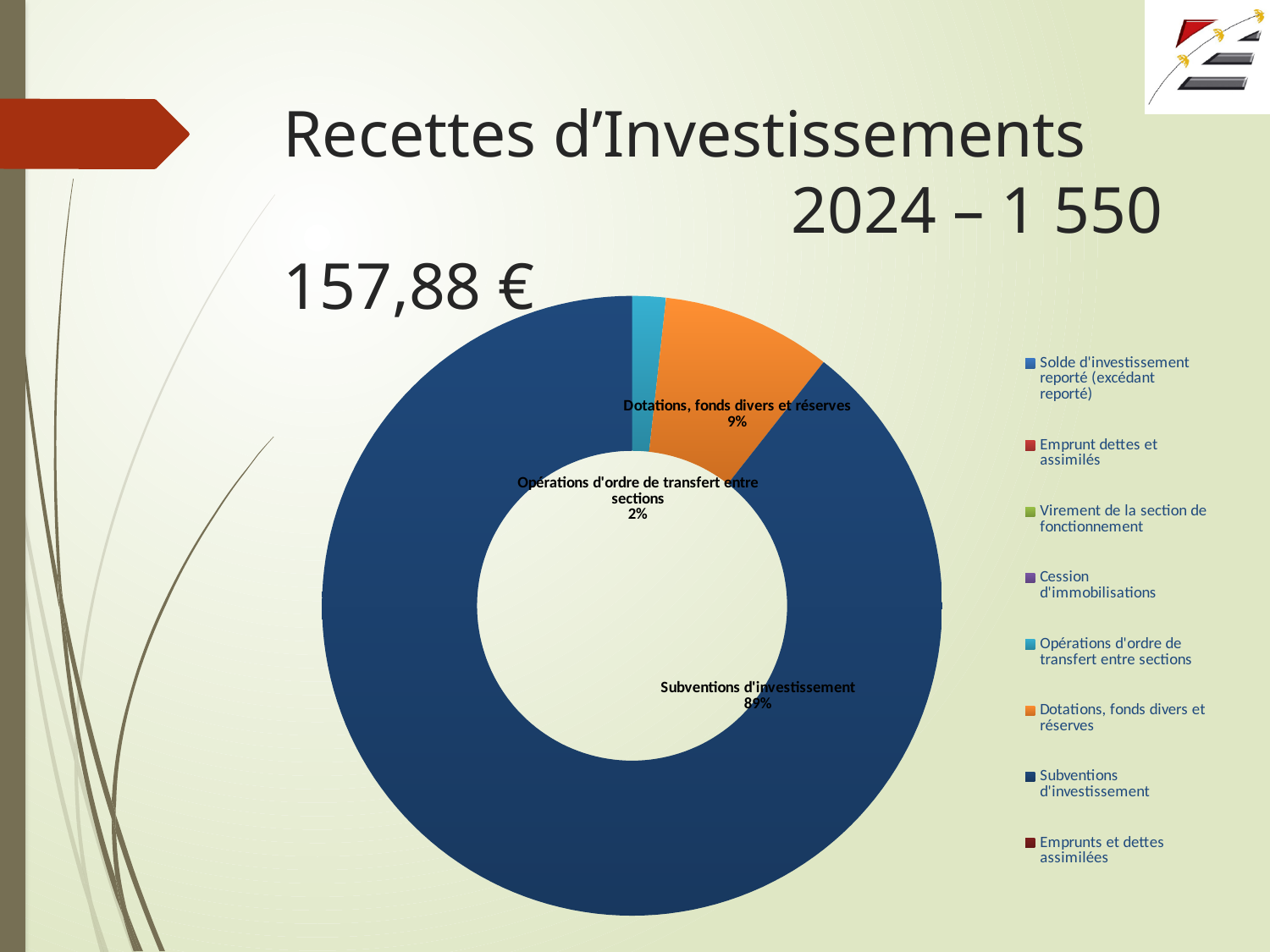
Which labelled category has the smallest share of the doughnut chart? Opérations d'ordre de transfert entre sections How many entries does the legend of the chart list? 8 Which category has the largest share of the doughnut chart? Subventions d'investissement How many slices of the chart carry a percentage data label? 3 What colour is the slice for Dotations, fonds divers et réserves? Orange What kind of chart is shown on the slide? Doughnut chart By how many percentage points does the share for Dotations, fonds divers et réserves exceed the share for Opérations d'ordre de transfert entre sections? 7 percentage points Which is larger: the share for Dotations, fonds divers et réserves or the share for Opérations d'ordre de transfert entre sections? Dotations, fonds divers et réserves What percentage share does the slice for Opérations d'ordre de transfert entre sections have? 2% What percentage share does the slice for Dotations, fonds divers et réserves have? 9% What percentage share does the slice for Subventions d'investissement have? 89% What is the title of the slide containing the chart? Recettes d'Investissements 2024 – 1 550 157,88 €